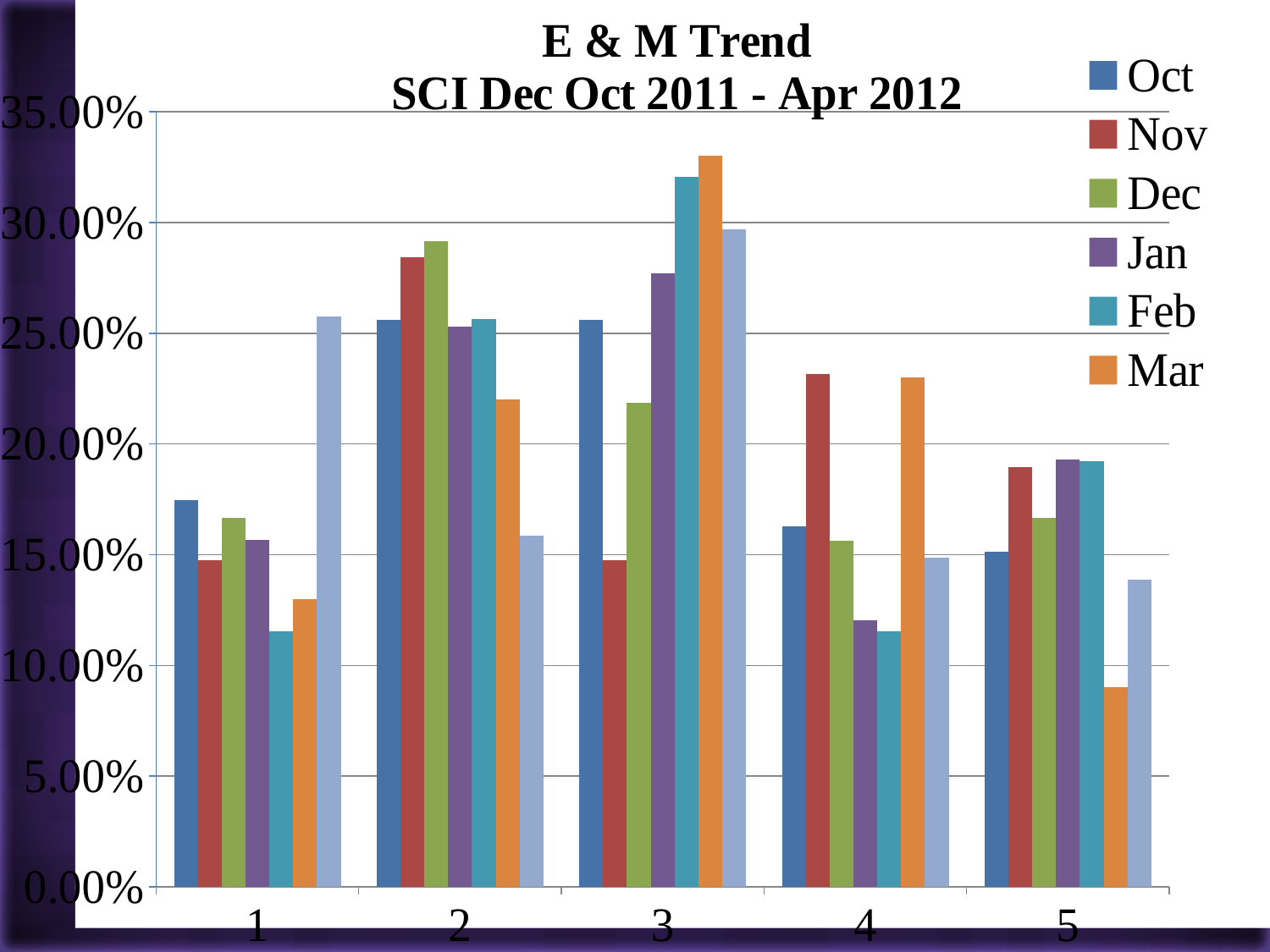
How many series does the legend list? 6 Which category has the highest Mar value? 3 Is the Oct value for category 1 greater or less than 15.00%? greater For category 3, which is larger, the Feb value or the Dec value? Feb Which series is listed first in the legend? Oct What kind of chart is shown on the slide? bar chart Which category has the lowest Mar value? 5 Is the Mar value for category 3 greater or less than 30.00%? greater What is the title of the chart? E & M Trend SCI Dec Oct 2011 - Apr 2012 Is the Mar value for category 5 greater or less than 10.00%? less How many categories are shown on the x axis? 5